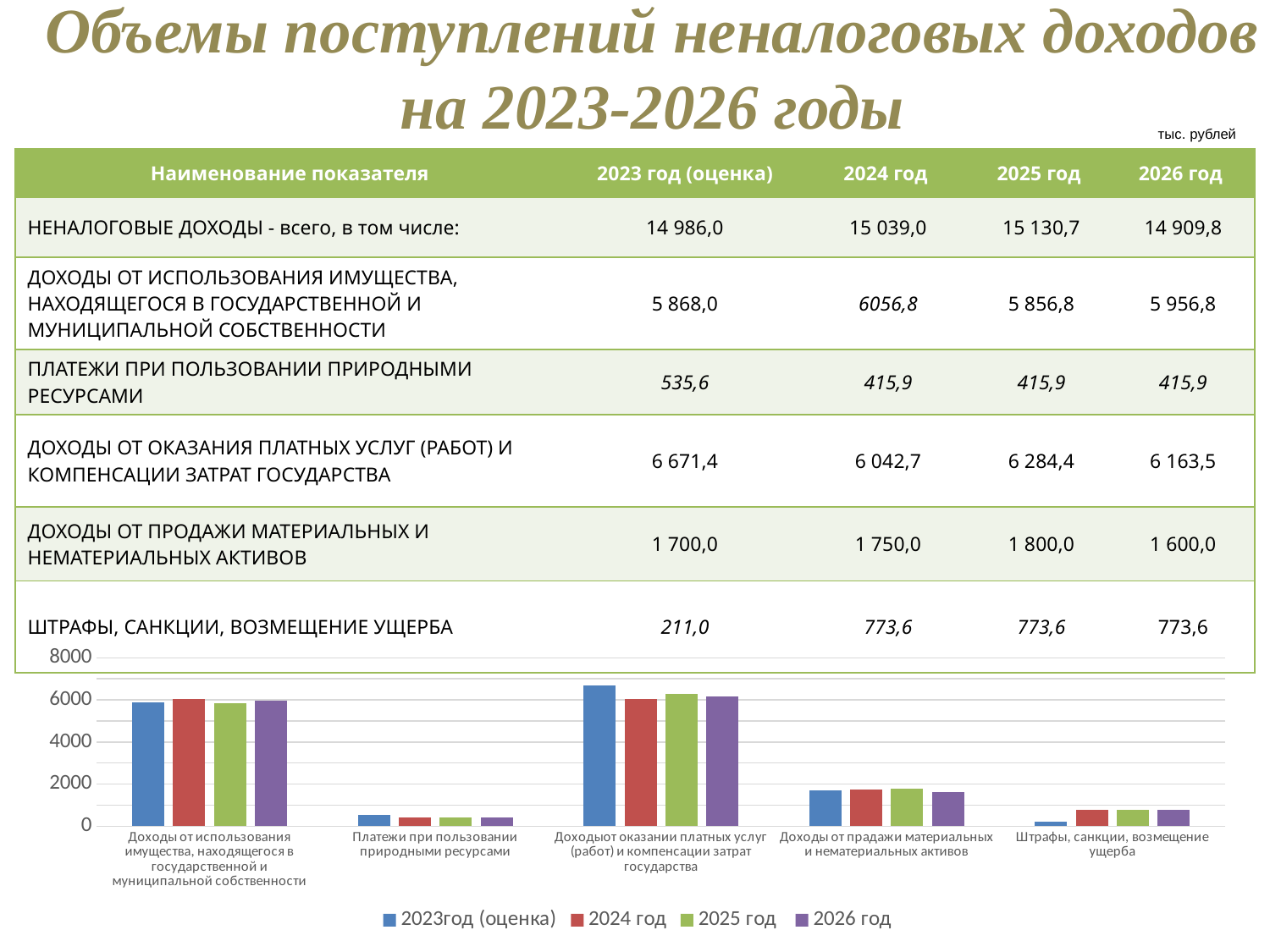
Using the table values, what is the difference between 2025 год and 2026 год for Доходы от продажи материальных и нематериальных активов? 200,0 Is the 2023 год (оценка) bar for Доходы от использования имущества greater or less than 4000? greater In the bar chart, which category has the tallest bar for 2023 год (оценка)? Доходы от оказания платных услуг (работ) и компенсации затрат государства How many series does the legend of the bar chart list? 4 According to the table, what is the value for Штрафы, санкции, возмещение ущерба in 2023 год (оценка)? 211,0 How many categories are shown on the x axis of the bar chart? 5 What colour represents the 2024 год series in the bar chart? red For Доходы от продажи материальных и нематериальных активов, which bar is taller: 2025 год or 2026 год? 2025 год Is the 2024 год bar for Платежи при пользовании природными ресурсами greater or less than 2000? less For Доходы от оказания платных услуг, which bar is taller: 2023 год (оценка) or 2024 год? 2023 год (оценка) What kind of chart is shown at the bottom of the slide? bar chart In the bar chart, which category has the lowest bar for 2023 год (оценка)? Штрафы, санкции, возмещение ущерба